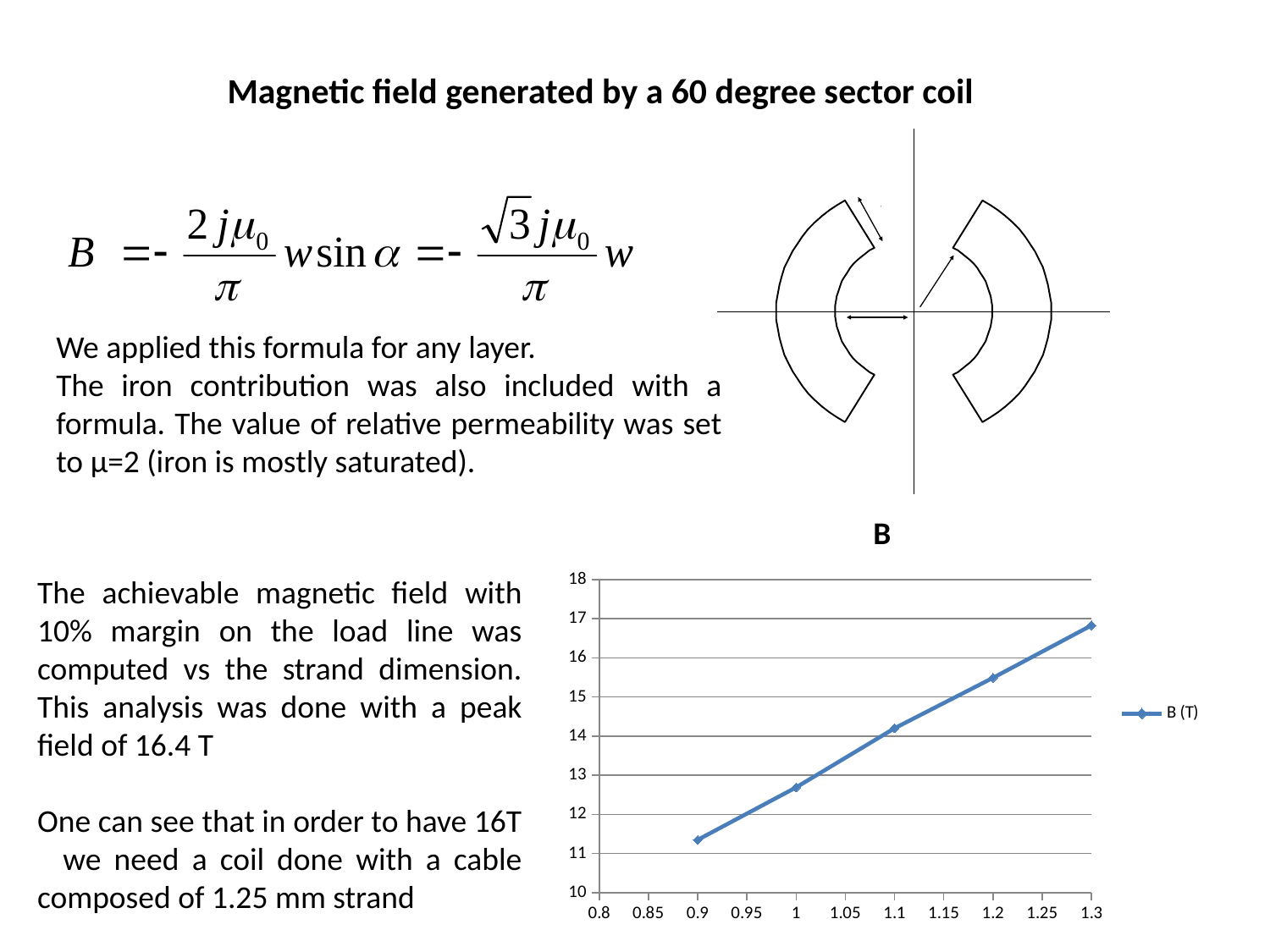
Is the value of B (T) at x = 0.9 greater or less than 12? less What is the name of the series shown in the chart legend? B (T) Is the value of B (T) at x = 1.3 greater or less than 16? greater How many series does the chart legend list? 1 How many data points are plotted on the B (T) line? 5 What type of chart is shown on the slide? line chart At which x-axis value is B (T) lowest? 0.9 Is the value of B (T) at x = 1.1 greater or less than 14? greater What is the title of the chart on the slide? B Which is larger, the value of B (T) at x = 1.0 or at x = 1.2? x = 1.2 Does the value of B (T) rise or fall as the x-axis value increases from 0.9 to 1.3? rise At which x-axis value is B (T) highest? 1.3